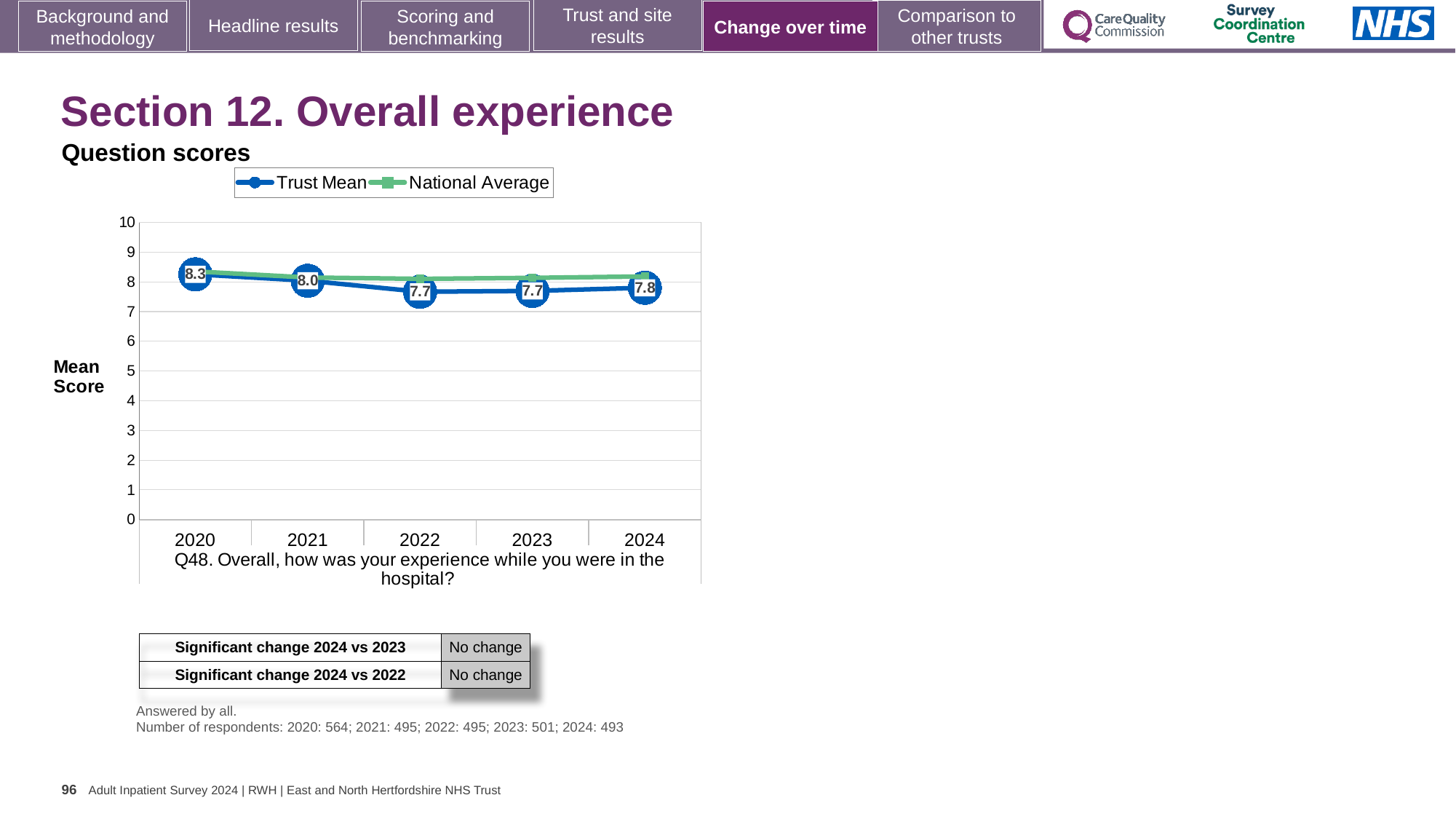
Is the National Average value for 2024 greater or less than 7? greater Which is larger, the Trust Mean score in 2021 or in 2024? 2021 In which year is the Trust Mean score highest? 2020 What is the Trust Mean score for 2021? 8.0 How many series does the legend list? 2 What is the Trust Mean score for 2020? 8.3 What kind of chart is shown? Line chart How many years are shown on the x axis? 5 What is the difference between the Trust Mean score in 2020 and in 2021? 0.3 What is the label of the y axis? Mean Score What is the Trust Mean score for 2024? 7.8 Does the Trust Mean score rise or fall from 2020 to 2022? Fall